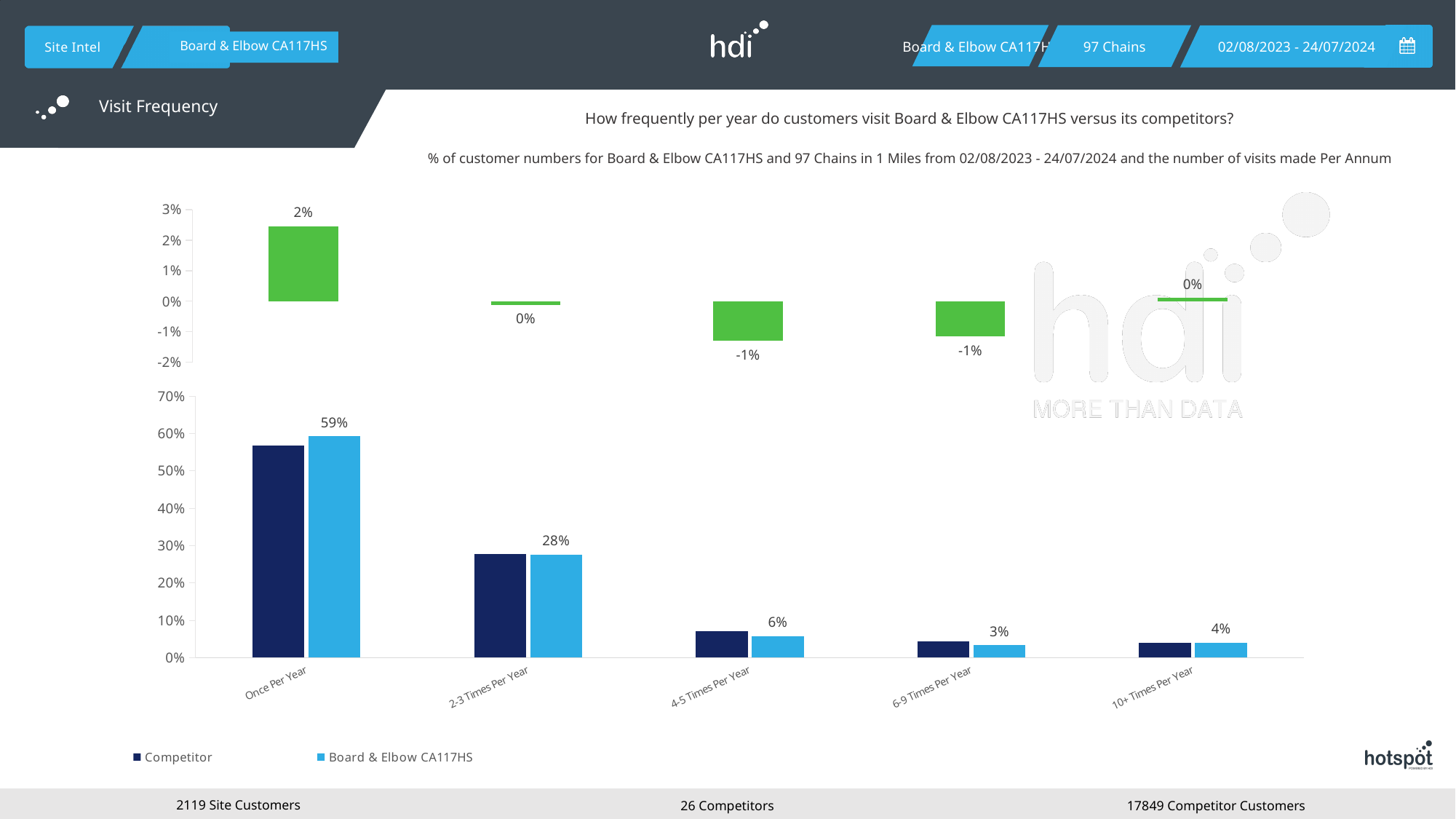
What kind of chart is the bottom chart? Bar chart In the bottom chart, is the Competitor value for 4-5 Times Per Year greater or less than 10%? less In the bottom chart, what is the value for Board & Elbow CA117HS for Once Per Year? 59% In the bottom chart, what is the value for Board & Elbow CA117HS for 2-3 Times Per Year? 28% How many series does the legend of the bottom chart list? 2 In the bottom chart, what is the difference between the Board & Elbow CA117HS values for Once Per Year and 2-3 Times Per Year? 31% In the bottom chart, which visit frequency category has the lowest value for Board & Elbow CA117HS? 6-9 Times Per Year In the top chart, what is the value shown for Once Per Year? 2% How many visit frequency categories are shown on the x axis of the bottom chart? 5 In the bottom chart, is the Competitor value for Once Per Year greater or less than 50%? greater In the bottom chart, what is the value for Board & Elbow CA117HS for 10+ Times Per Year? 4% In the bottom chart, which visit frequency category has the highest value for Board & Elbow CA117HS? Once Per Year